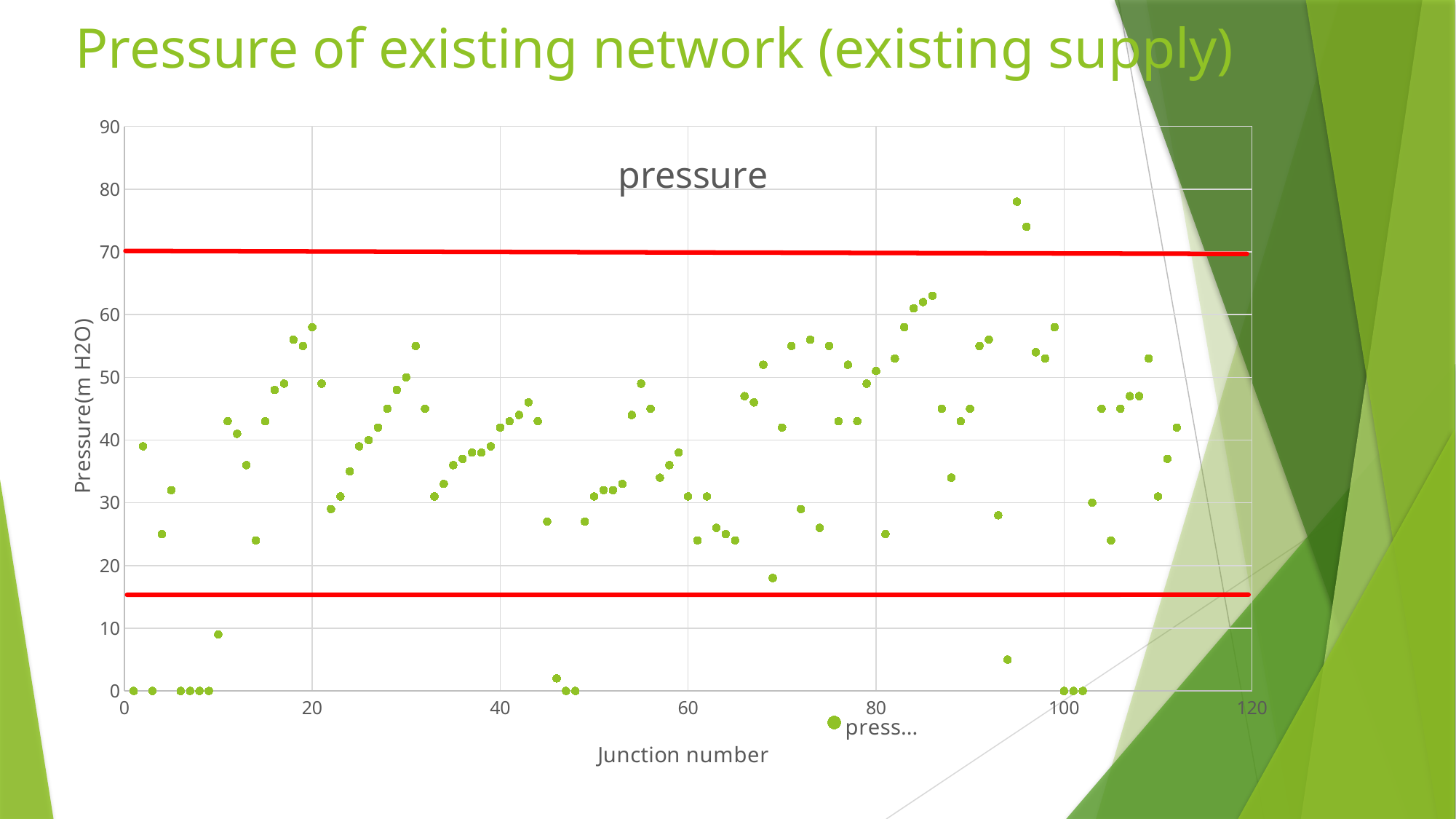
Is the pressure value at junction 14 greater or less than 30? less What is the label of the vertical axis? Pressure(m H2O) Which has the larger pressure value, junction 10 or junction 20? junction 20 Is the pressure value at junction 2 greater or less than 30? greater Is the pressure value at junction 86 greater or less than 60? greater How many series does the legend list? 1 What kind of chart is shown on the slide? scatter chart What is the title shown inside the chart? pressure